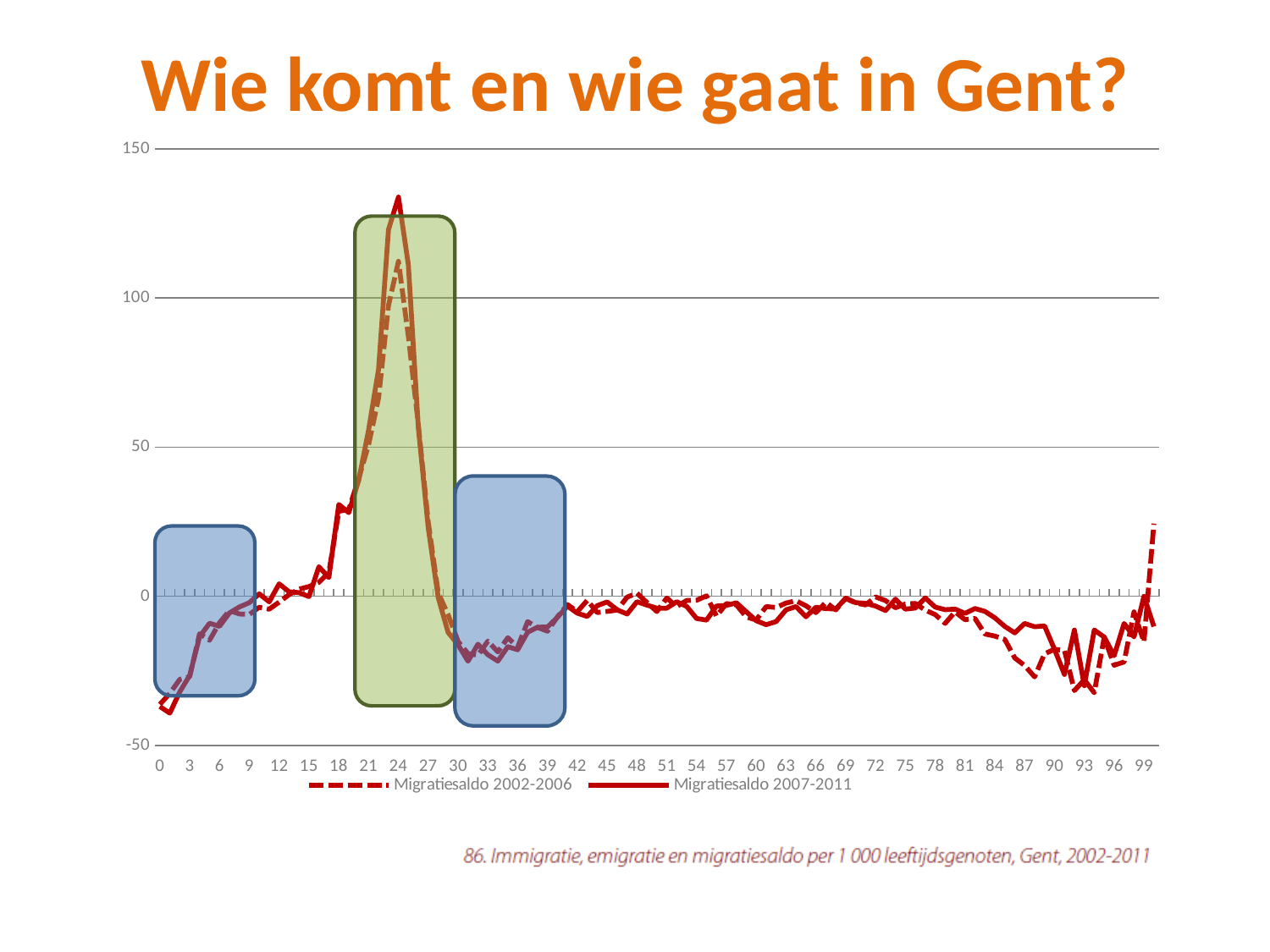
Is the peak value of the Migratiesaldo 2002-2006 line (around age 24) greater or less than 50? greater What kind of chart is shown on the slide? line chart Is the value of the Migratiesaldo 2007-2011 line at age 90 greater or less than 0? less Is the peak value of the Migratiesaldo 2007-2011 line (around age 24) greater or less than 100? greater Between age 24 and age 30, do the values of the Migratiesaldo 2007-2011 line rise or fall? fall At the peak around age 24, which series reaches the higher value: Migratiesaldo 2002-2006 or Migratiesaldo 2007-2011? Migratiesaldo 2007-2011 What are the two series named in the legend? Migratiesaldo 2002-2006 and Migratiesaldo 2007-2011 Which series is drawn with a dashed line? Migratiesaldo 2002-2006 How many series does the legend list? 2